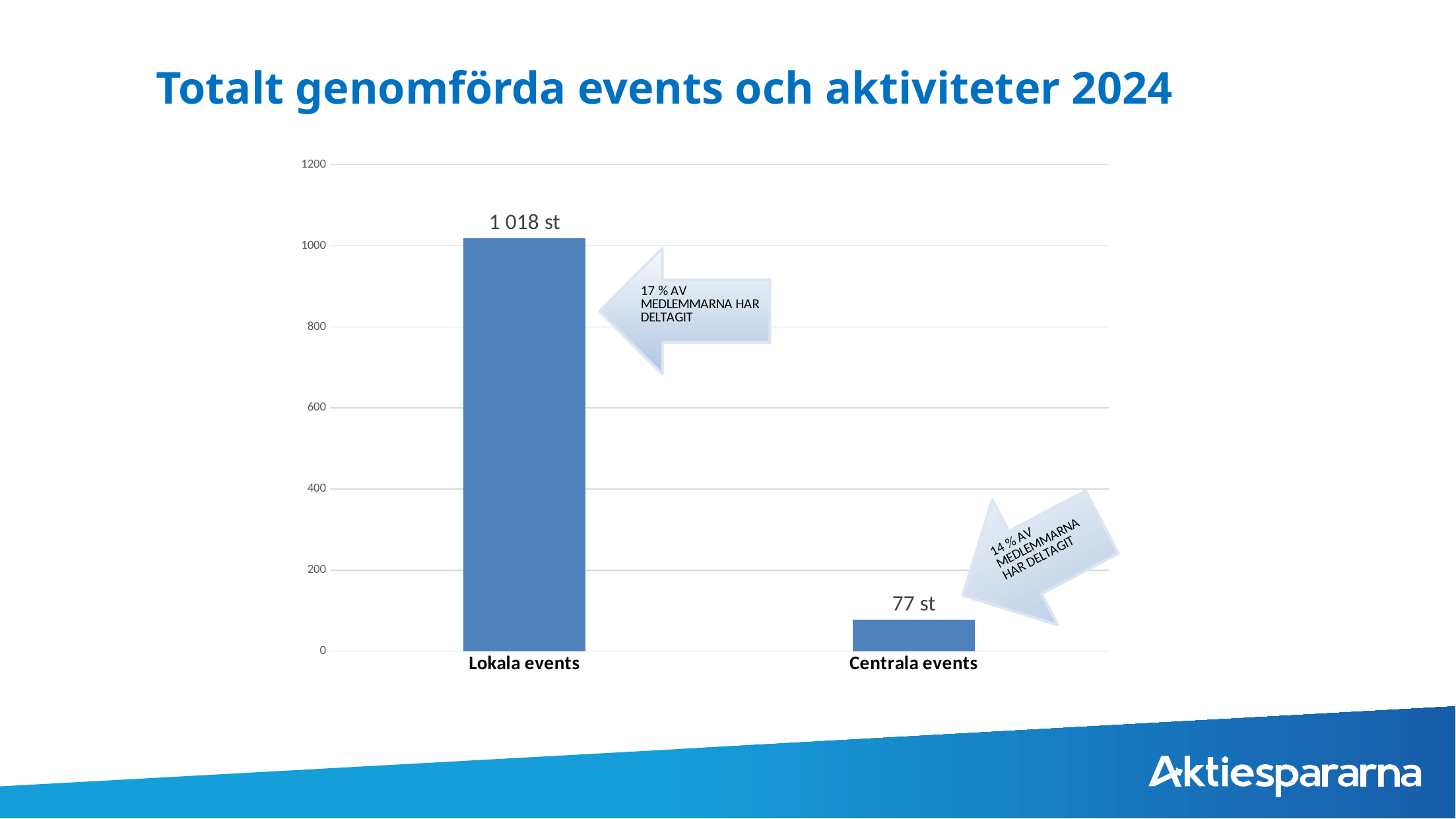
What is the title of the slide? Totalt genomförda events och aktiviteter 2024 What kind of chart is shown on the slide? bar chart What is the difference between the values for Lokala events and Centrala events? 941 Which category has the lowest value? Centrala events Is the value for Lokala events greater or less than 1000? greater Which category has the highest value? Lokala events What is the value for Centrala events? 77 st How many categories are shown on the x axis? 2 Which is larger, the value for Lokala events or the value for Centrala events? Lokala events Is the value for Centrala events greater or less than 200? less According to the arrow next to the Lokala events bar, what percentage of members participated? 17 % What is the value for Lokala events? 1 018 st